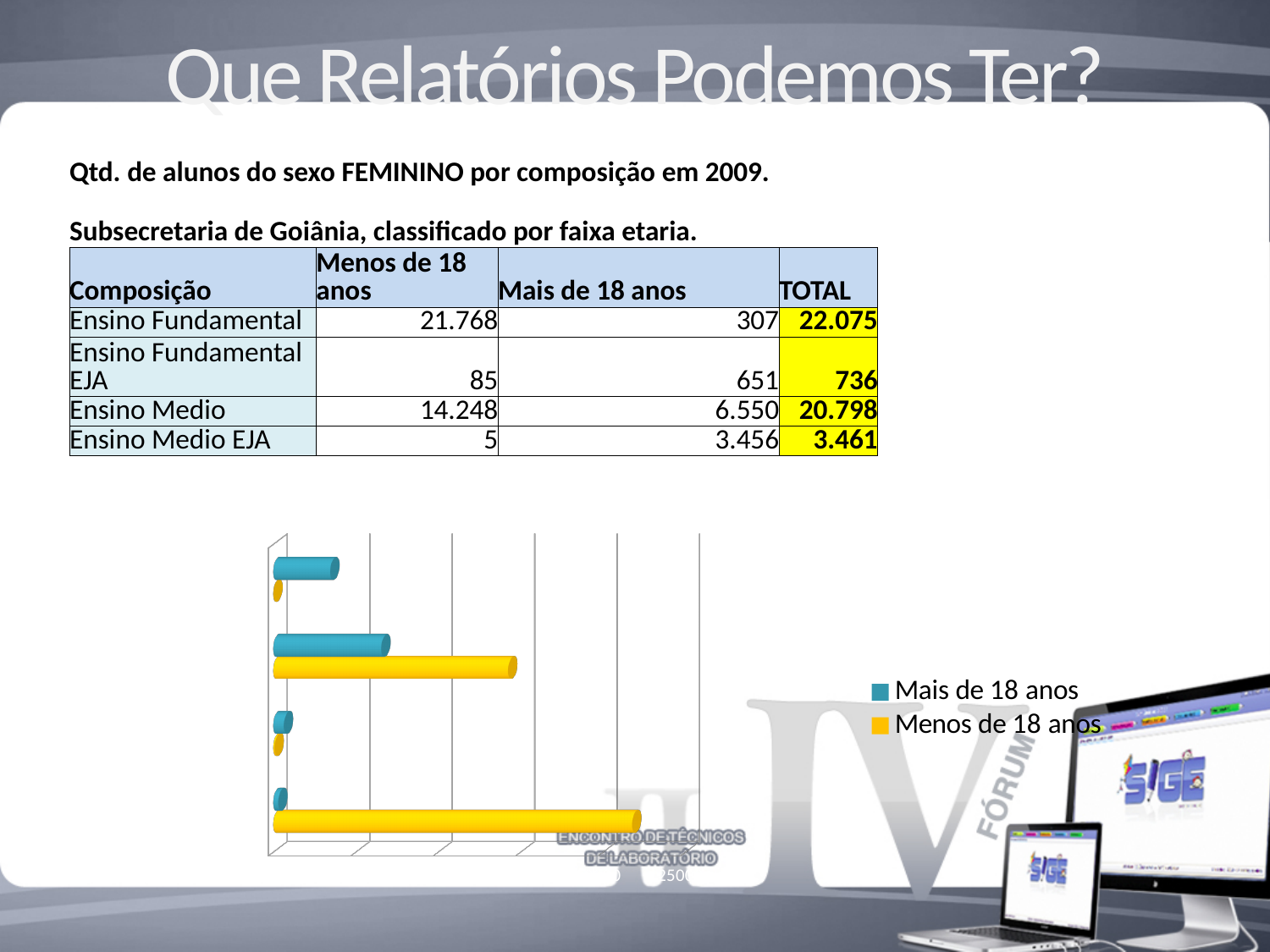
How many categories (groups of bars) are plotted in the chart? 4 Which colour represents the series 'Menos de 18 anos' in the chart? yellow What are the two series named in the chart's legend? Mais de 18 anos; Menos de 18 anos Which series has the longest bar in the chart? Menos de 18 anos Are the bars in the chart drawn horizontally or vertically? horizontally How many series does the chart's legend list? 2 What kind of chart is shown on the slide? bar chart